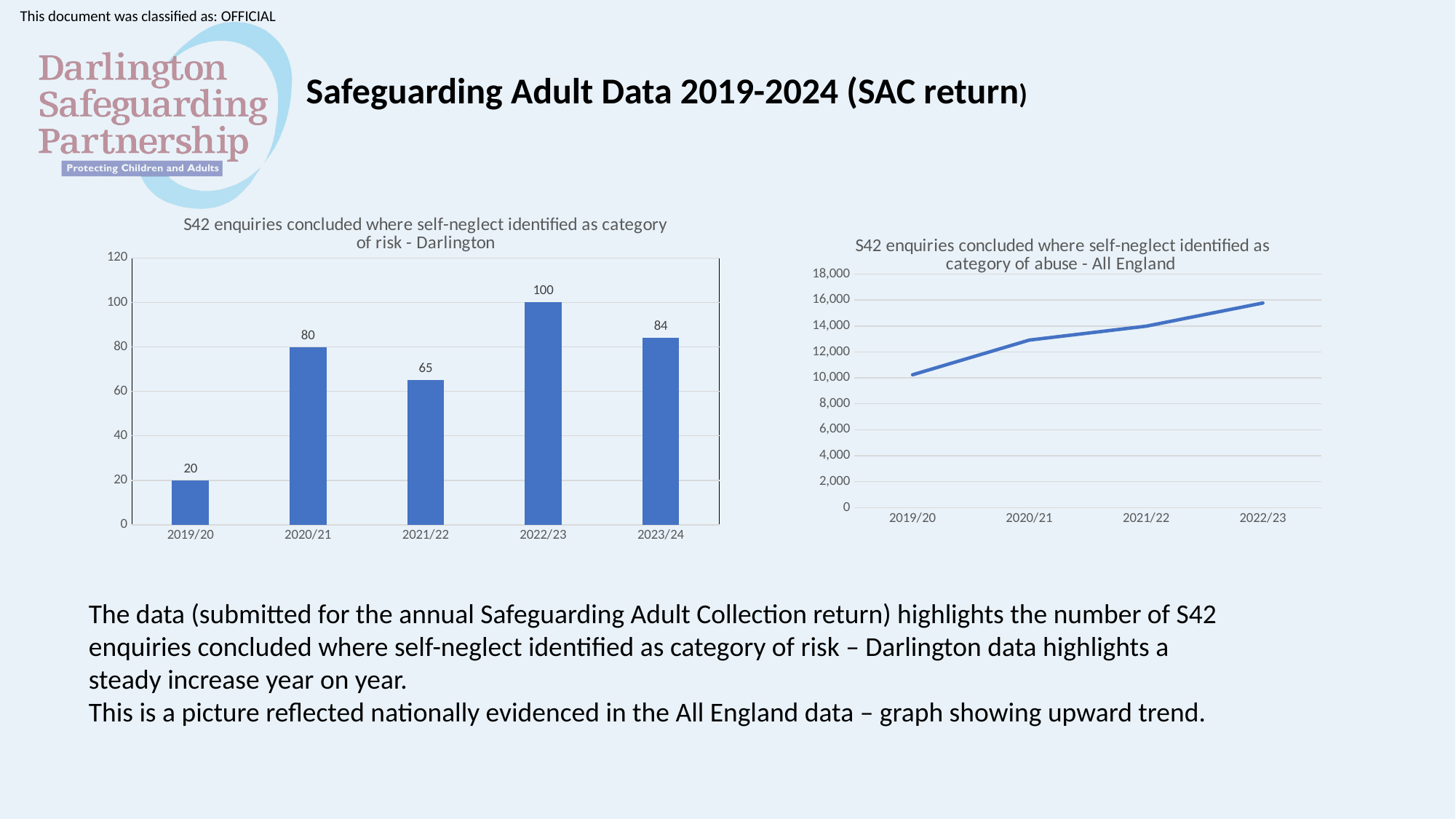
In the Darlington chart, what is the value for 2023/24? 84 In the All England chart, is the value for 2022/23 greater or less than 14,000? greater In the Darlington chart, which year has the highest value? 2022/23 In the Darlington chart, what is the value for 2019/20? 20 In the Darlington chart, which year has the lowest value? 2019/20 In the Darlington chart, what is the difference between the values for 2020/21 and 2021/22? 15 In the Darlington chart, what is the value for 2022/23? 100 What kind of chart is the All England chart? line chart In the Darlington chart, which is larger, the value for 2023/24 or the value for 2020/21? 2023/24 In the All England chart, do the values rise or fall from 2019/20 to 2022/23? rise How many years are shown in the Darlington chart? 5 What kind of chart is the Darlington chart? bar chart